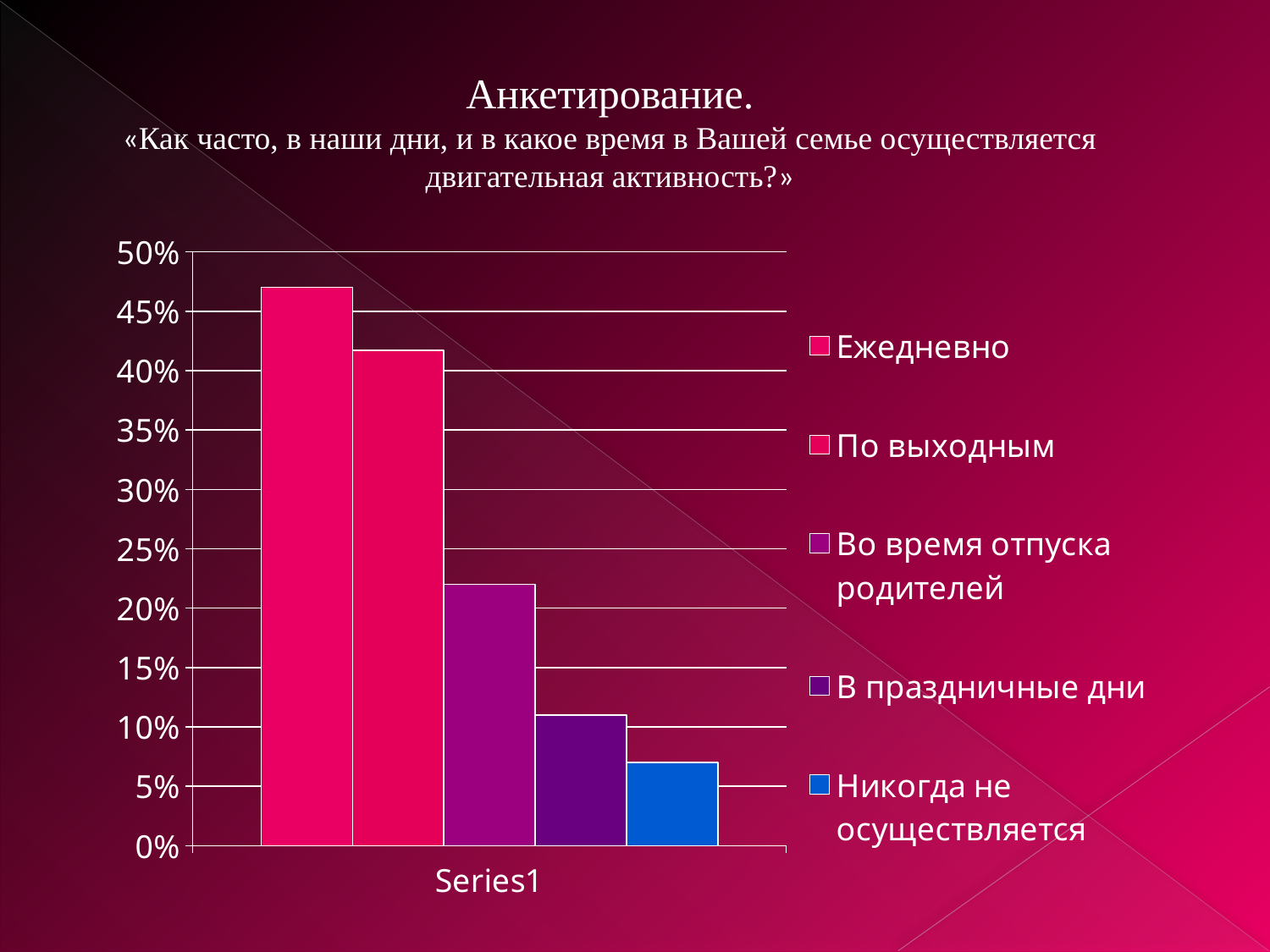
Which legend entry has the shortest bar? Никогда не осуществляется Which is larger, the value for По выходным or the value for Во время отпуска родителей? По выходным What kind of chart is shown on the slide? bar chart Is the value for Во время отпуска родителей greater or less than 25%? less What is the label shown on the horizontal axis of the chart? Series1 Which is larger, the value for В праздничные дни or the value for Никогда не осуществляется? В праздничные дни Is the value for По выходным greater or less than 40%? greater How many series does the legend list? 5 Is the value for Ежедневно greater or less than 45%? greater Which legend entry has the tallest bar? Ежедневно